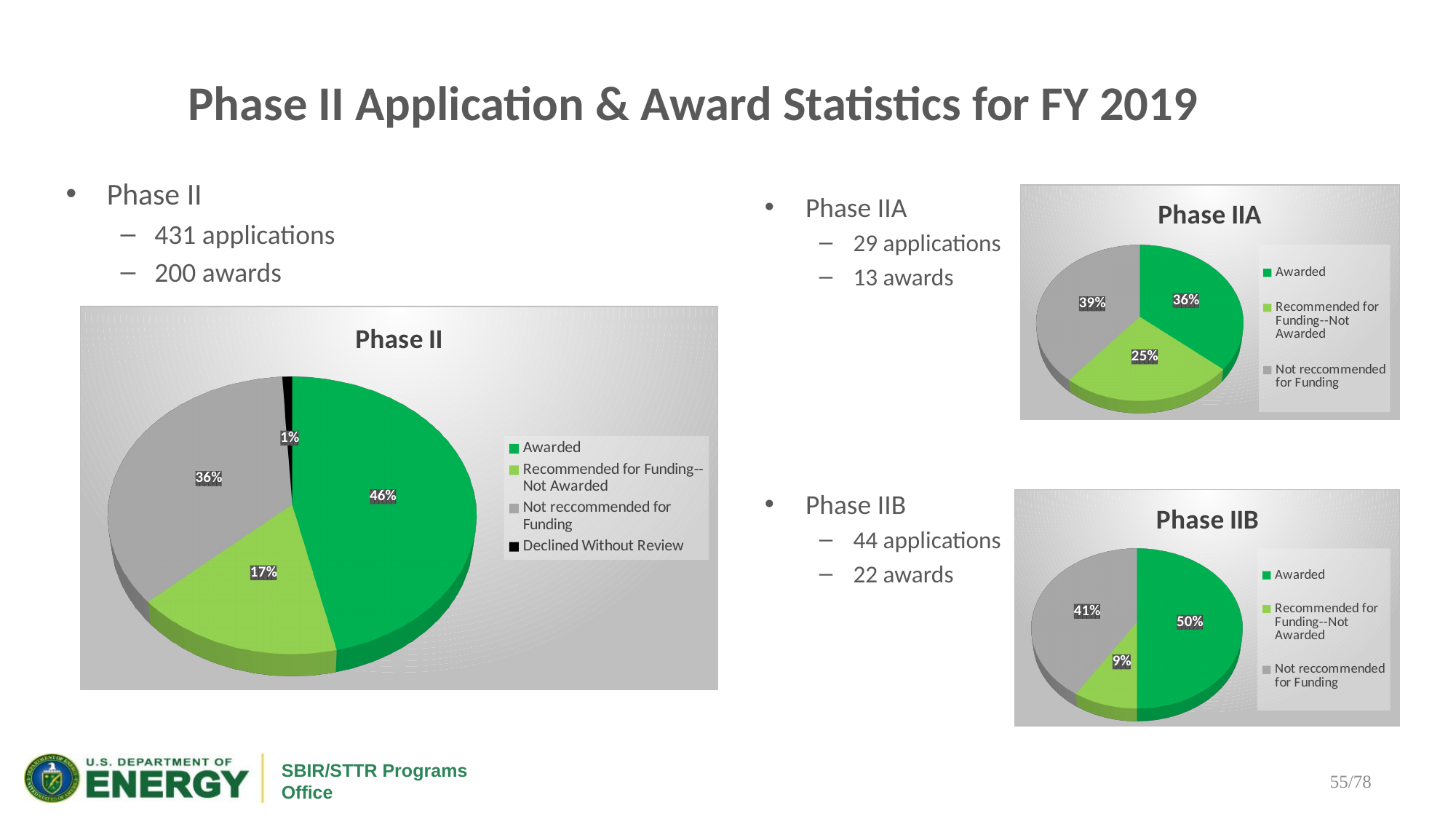
What kind of chart is the Phase IIB chart? Pie chart In the Phase II chart, what share of the pie is Awarded? 46% In the Phase IIB chart, which category has the smallest slice? Recommended for Funding--Not Awarded In the Phase IIB chart, what share of the pie is Awarded? 50% In the Phase IIA chart, which is larger, Awarded or Recommended for Funding--Not Awarded? Awarded In the Phase IIA chart, which category has the largest slice? Not recommended for Funding In the Phase II chart, what is the difference in percentage points between Not recommended for Funding and Recommended for Funding--Not Awarded? 19 How many categories does the legend of the Phase II chart list? 4 In the Phase IIA chart, what share of the pie is Not recommended for Funding? 39% In the Phase II chart, what share of the pie is Declined Without Review? 1% In the Phase II chart, which category has the largest slice? Awarded In the Phase II chart, which category has the smallest slice? Declined Without Review